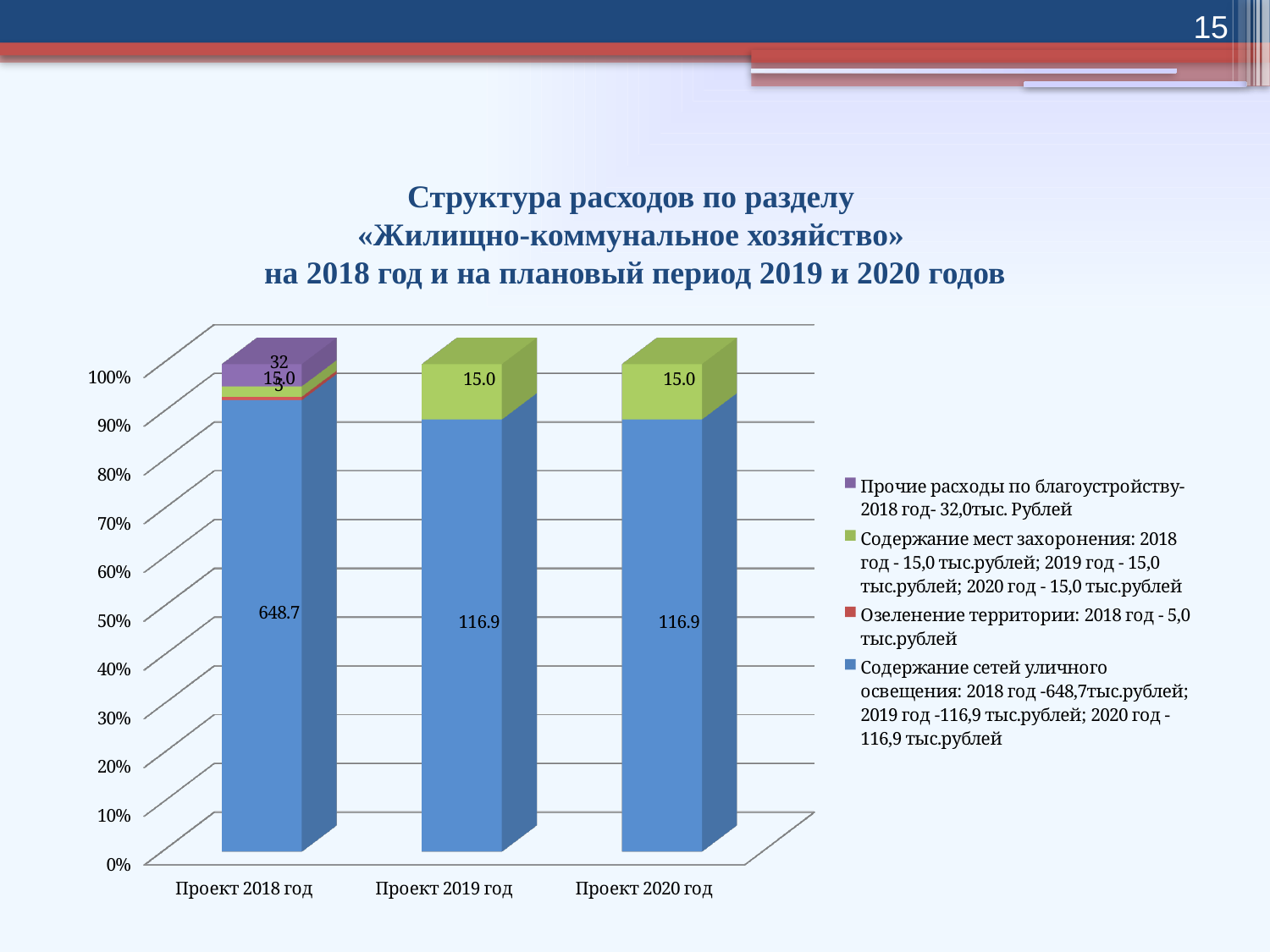
What is the value labelled for Содержание сетей уличного освещения in the Проект 2019 год bar? 116.9 How many series does the chart legend list? 4 What is the value labelled for Содержание мест захоронения in the Проект 2020 год bar? 15.0 What is the difference between the Содержание сетей уличного освещения values for Проект 2018 год and Проект 2019 год? 531.8 Is the share of the Содержание сетей уличного освещения segment in the Проект 2019 год bar greater or less than 80%? greater What is the value labelled for Содержание сетей уличного освещения in the Проект 2018 год bar? 648.7 Which is larger, the Содержание сетей уличного освещения value for Проект 2018 год or for Проект 2020 год? Проект 2018 год How many categories (years) are shown on the x axis of the chart? 3 What kind of chart is shown on the slide? Stacked bar chart Which year has the highest value for Содержание сетей уличного освещения? Проект 2018 год What is the total of the labelled values in the Проект 2019 год stacked bar? 131.9 What is the value labelled for Прочие расходы по благоустройству in the Проект 2018 год bar? 32